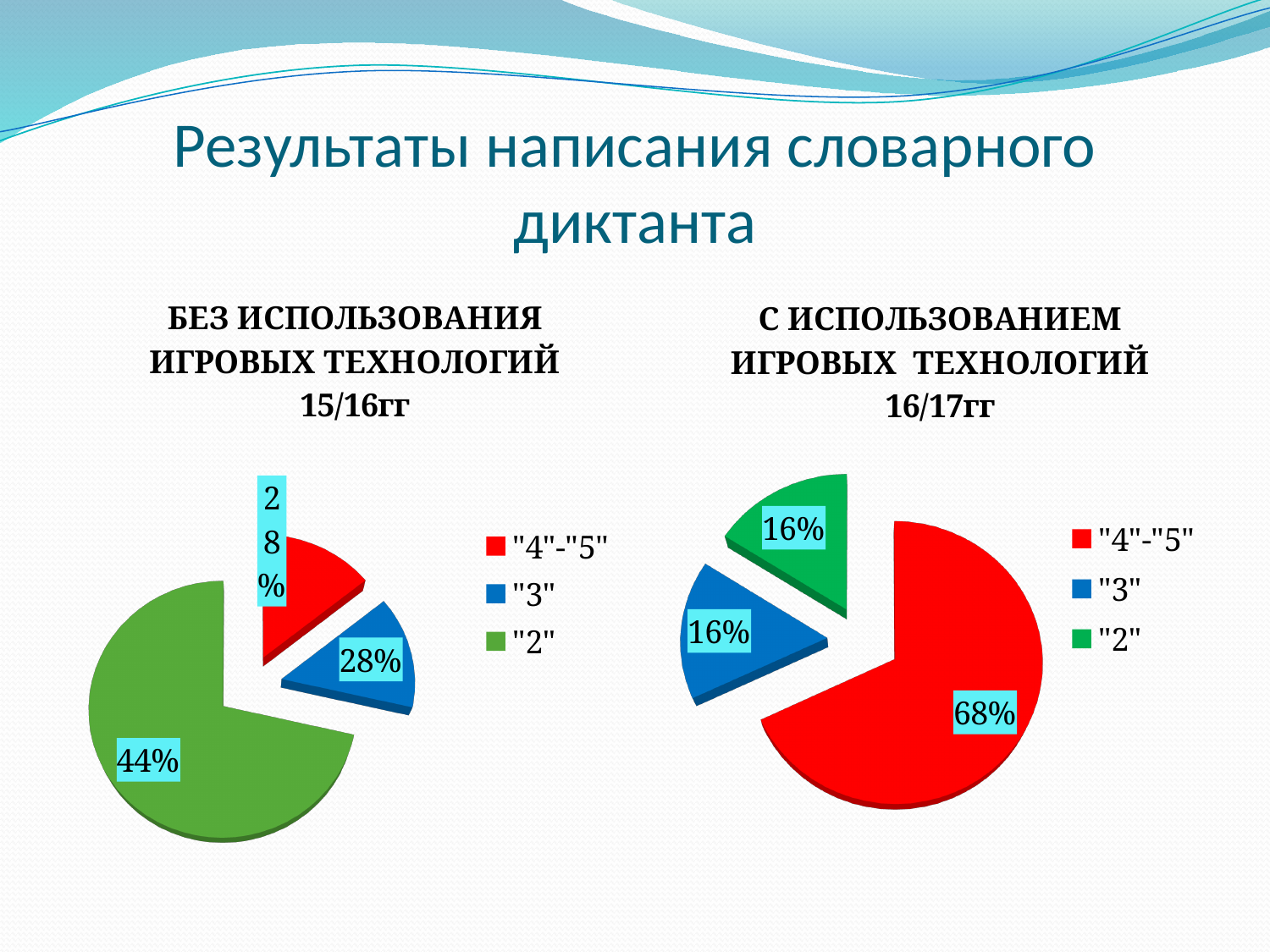
In the left chart (15/16гг), what is the value for the "3" slice? 28% What type of chart is used on this slide? Pie chart In the left chart (15/16гг, without game technologies), what share of the pie is the "2" slice? 44% In the left chart (15/16гг), which category has the largest slice? "2" In the right chart (16/17гг), which category has the largest slice? "4"-"5" In the right chart (16/17гг), what is the value for the "2" slice? 16% In the right chart (16/17гг), what is the difference between the "4"-"5" slice and the "3" slice? 52% In the right chart (16/17гг), what is the value for the "3" slice? 16% In the left chart (15/16гг), what is the value for the "4"-"5" slice? 28% How many slices does the left chart (15/16гг) have? 3 Which is larger: the "4"-"5" share in the left chart (15/16гг) or the "4"-"5" share in the right chart (16/17гг)? The right chart (16/17гг) In the right chart (16/17гг, with game technologies), what share of the pie is the "4"-"5" slice? 68%